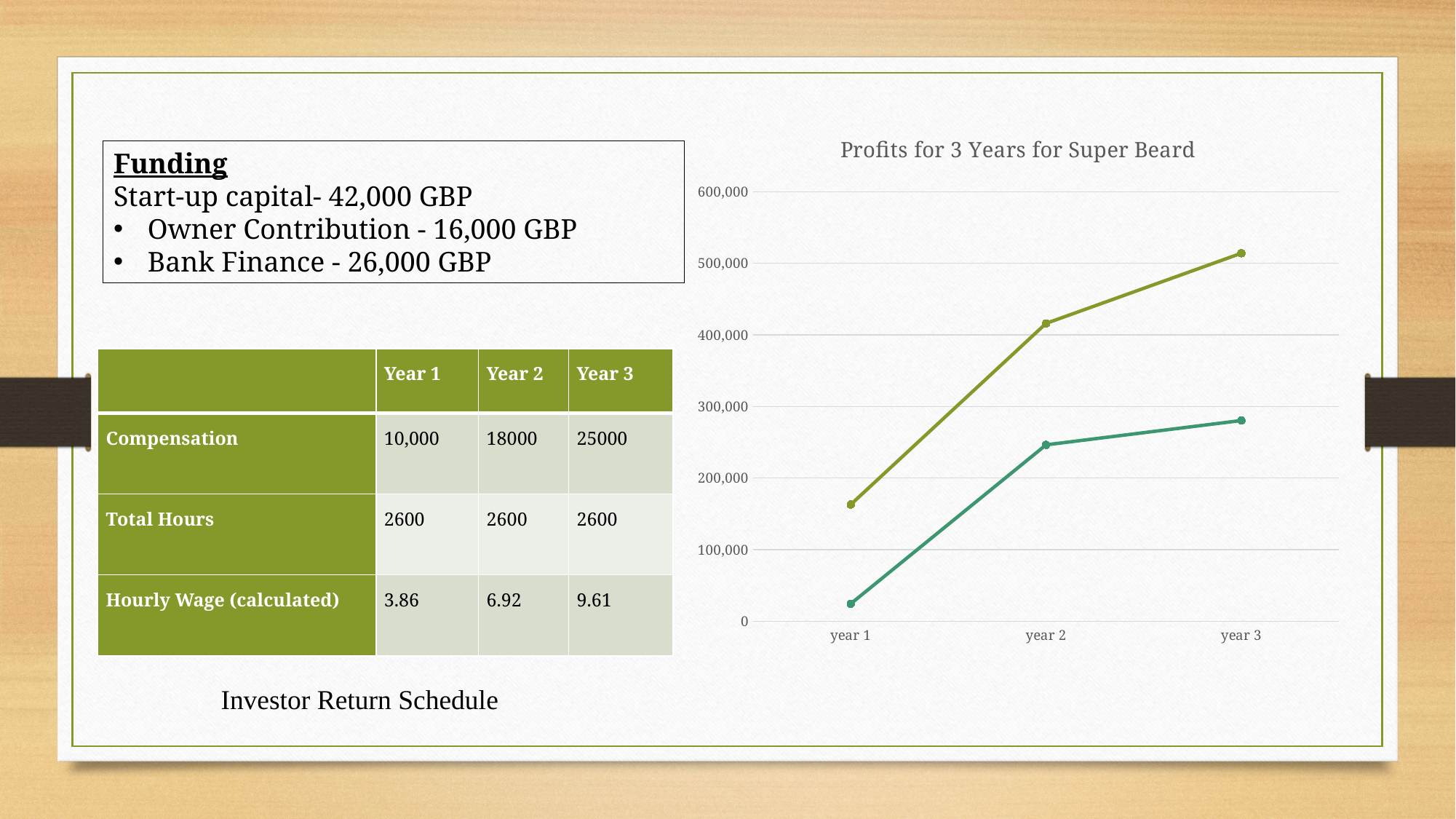
Do the values of the lower (teal) line rise or fall from year 1 to year 3? rise For the lower (teal) line, which year has the lowest value? year 1 Is the value of the upper (olive-green) line at year 2 greater or less than 400,000? greater At year 2, which line has the larger value, the upper (olive-green) line or the lower (teal) line? the upper (olive-green) line How many categories are shown on the x axis of the chart? 3 For the upper (olive-green) line, which year has the highest value? year 3 What is the title of the chart on the slide? Profits for 3 Years for Super Beard Do the values of the upper (olive-green) line rise or fall from year 1 to year 3? rise Is the value of the lower (teal) line at year 1 greater or less than 100,000? less How many data series (lines) are plotted on the chart? 2 What type of chart is shown on the slide? line chart Is the value of the lower (teal) line at year 3 greater or less than 300,000? less